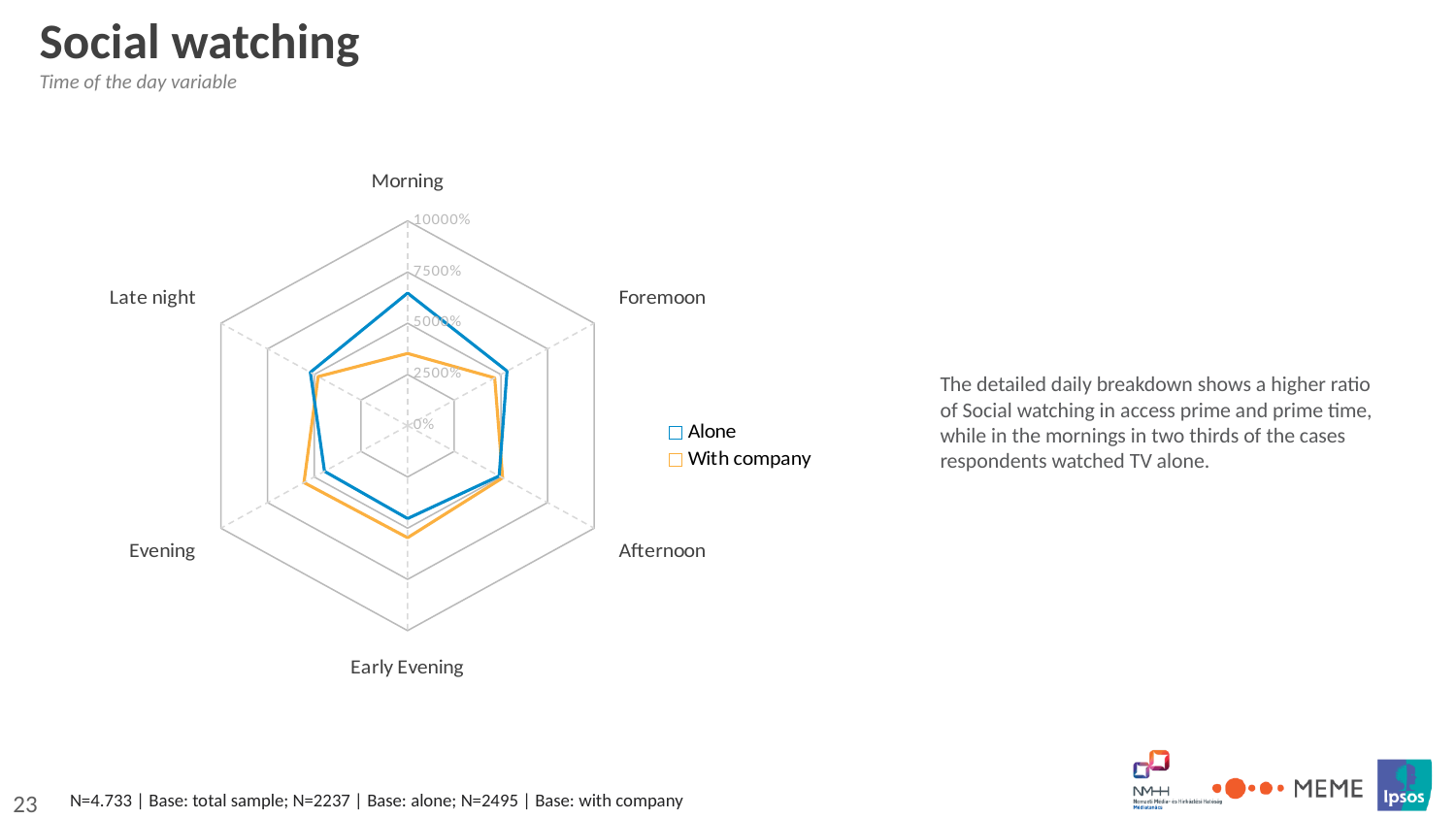
What is the title of the slide containing the chart? Social watching How many categories (times of day) does the radar chart have? 6 What are the two series named in the legend? Alone and With company How many series does the legend list? 2 At Foremoon, which series has the larger value, Alone or With company? Alone For which time of day is the With company series lowest? Morning Is the Alone value for Morning greater or less than 5000%? greater What kind of chart is shown on the slide? Radar chart Is the With company value for Morning greater or less than 5000%? less At Early Evening, which series has the larger value, Alone or With company? With company For which time of day is the Alone series highest? Morning At Morning, which series has the larger value, Alone or With company? Alone